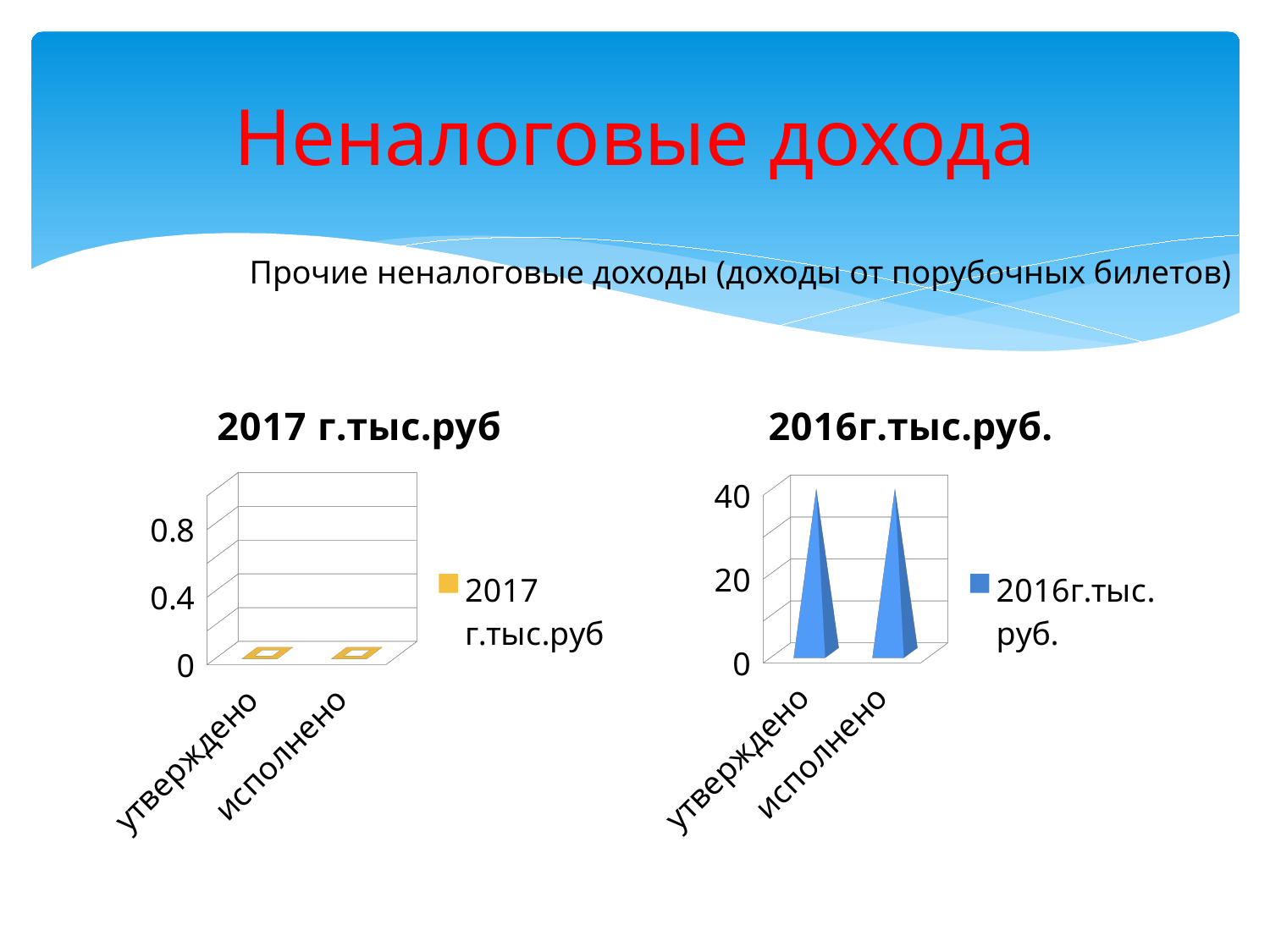
In the chart titled "2017 г.тыс.руб", is the value for утверждено greater or less than 0.4? less In the chart titled "2017 г.тыс.руб", how many series does the legend list? 1 In the chart titled "2017 г.тыс.руб", how many categories are shown on the x axis? 2 In the chart titled "2016г.тыс.руб.", how many series does the legend list? 1 In the chart titled "2017 г.тыс.руб", is the value for исполнено greater or less than 0.4? less In the chart titled "2017 г.тыс.руб", what is the legend entry? 2017 г.тыс.руб In the chart titled "2016г.тыс.руб.", is the value for исполнено greater or less than 20? greater What kind of chart is the chart titled "2016г.тыс.руб."? bar chart In the chart titled "2016г.тыс.руб.", how many categories are shown on the x axis? 2 What is the title of the chart on the right side of the slide? 2016г.тыс.руб. What kind of chart is the chart titled "2017 г.тыс.руб"? bar chart